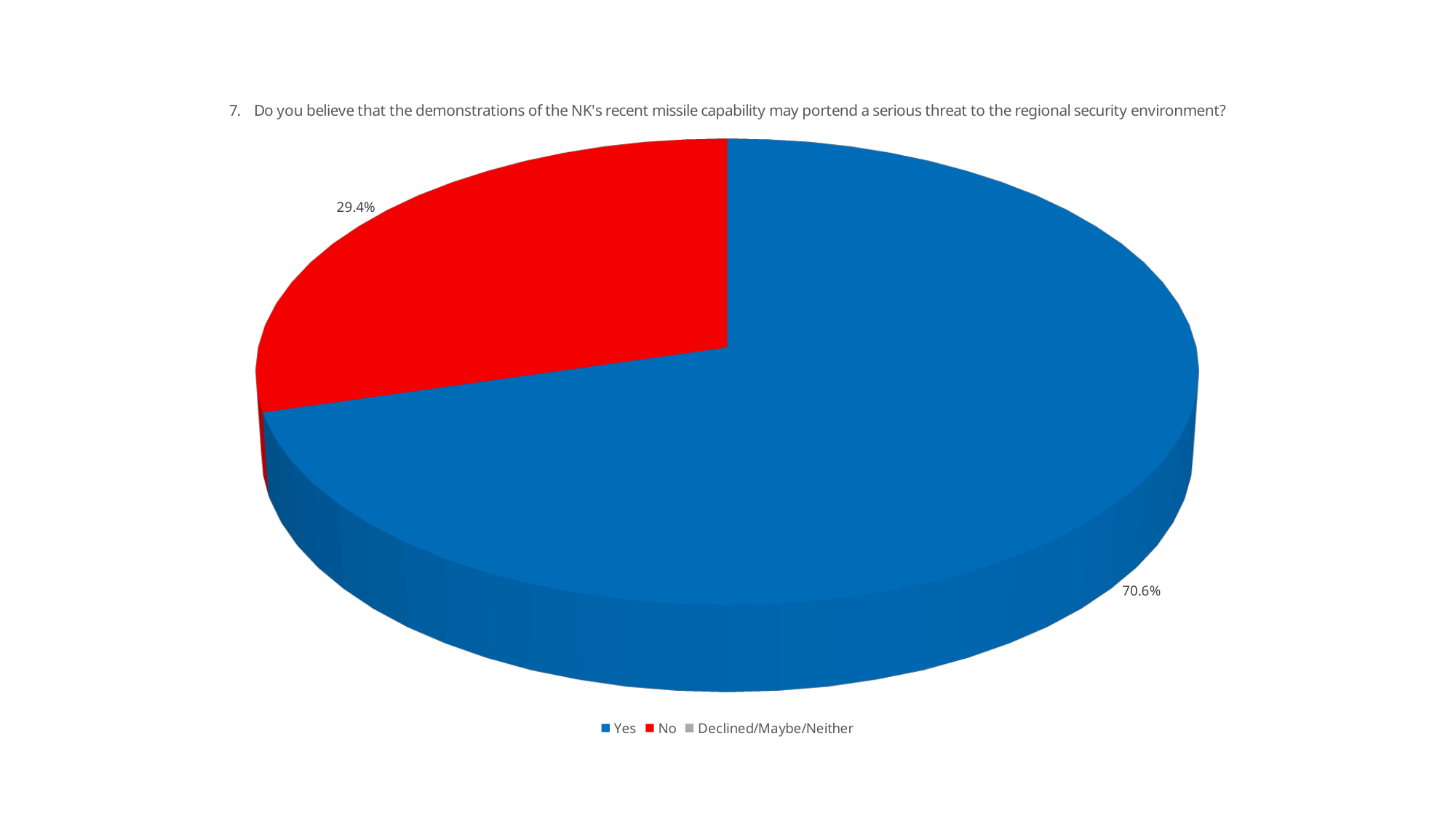
What percentage of respondents answered "No"? 29.4% What kind of chart is shown on the slide? Pie chart Which legend entry has no visible slice in the pie? Declined/Maybe/Neither What colour is the "No" slice? Red How many entries does the legend list? 3 What percentage of respondents answered "Yes"? 70.6% What is the difference in percentage points between the "Yes" and "No" responses? 41.2 Which response has the largest share of the pie? Yes Is the share for "Yes" greater or less than 50%? greater Is the share for "Yes" larger than the share for "No"? Yes Which of the two visible slices is smaller, "Yes" or "No"? No